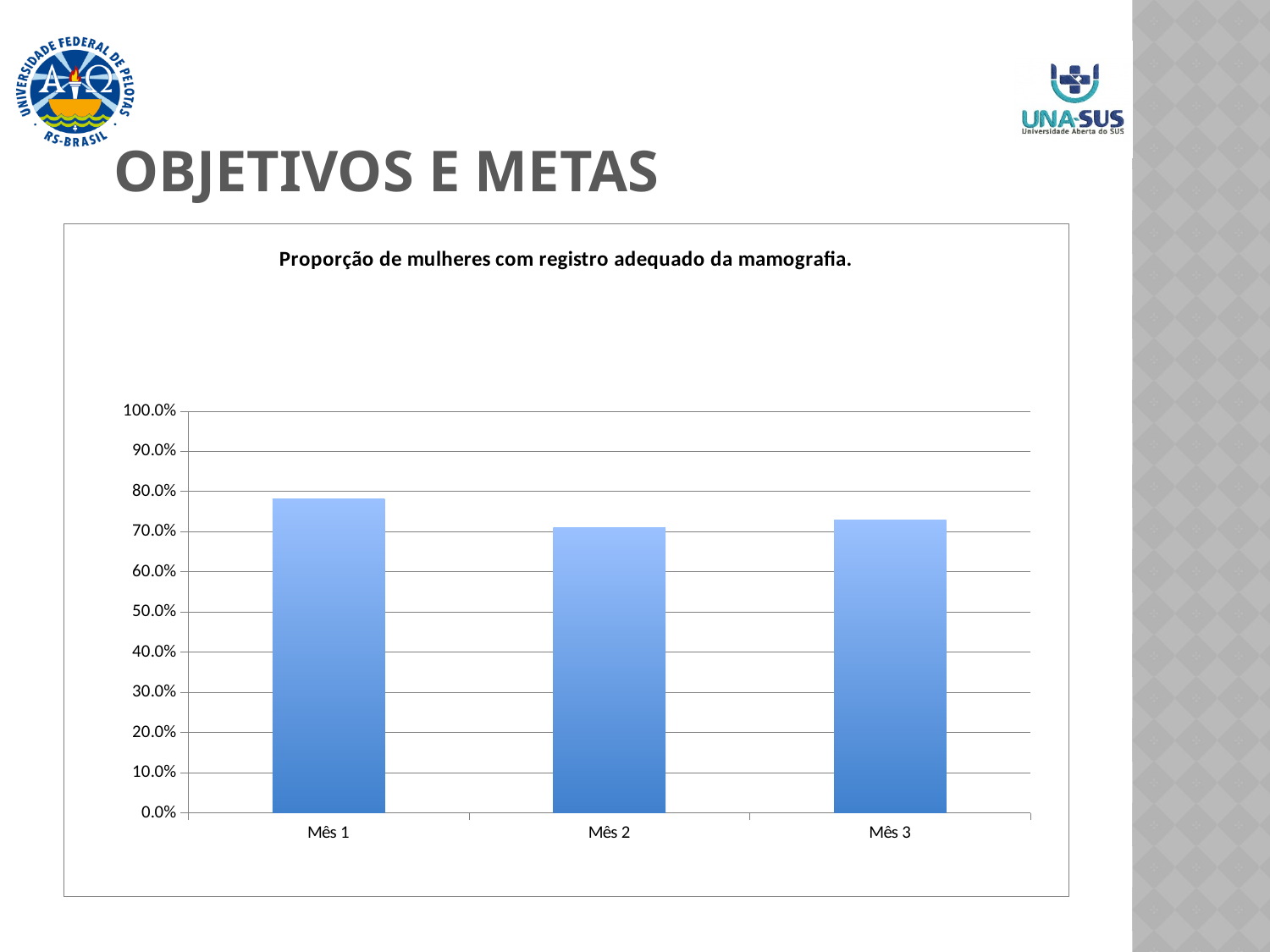
Is the value for Mês 2 greater or less than 80.0%? less Is the value for Mês 3 greater or less than 80.0%? less Is the value for Mês 1 greater or less than 70.0%? greater Which month has the highest bar in the chart? Mês 1 What type of chart is shown on the slide? bar chart What is the title of the chart? Proporção de mulheres com registro adequado da mamografia. Does the value rise or fall from Mês 1 to Mês 2? fall What is the highest value shown on the vertical axis of the chart? 100.0% How many categories (months) are plotted in the chart? 3 Which is larger, the value for Mês 1 or the value for Mês 3? Mês 1 Which is larger, the value for Mês 1 or the value for Mês 2? Mês 1